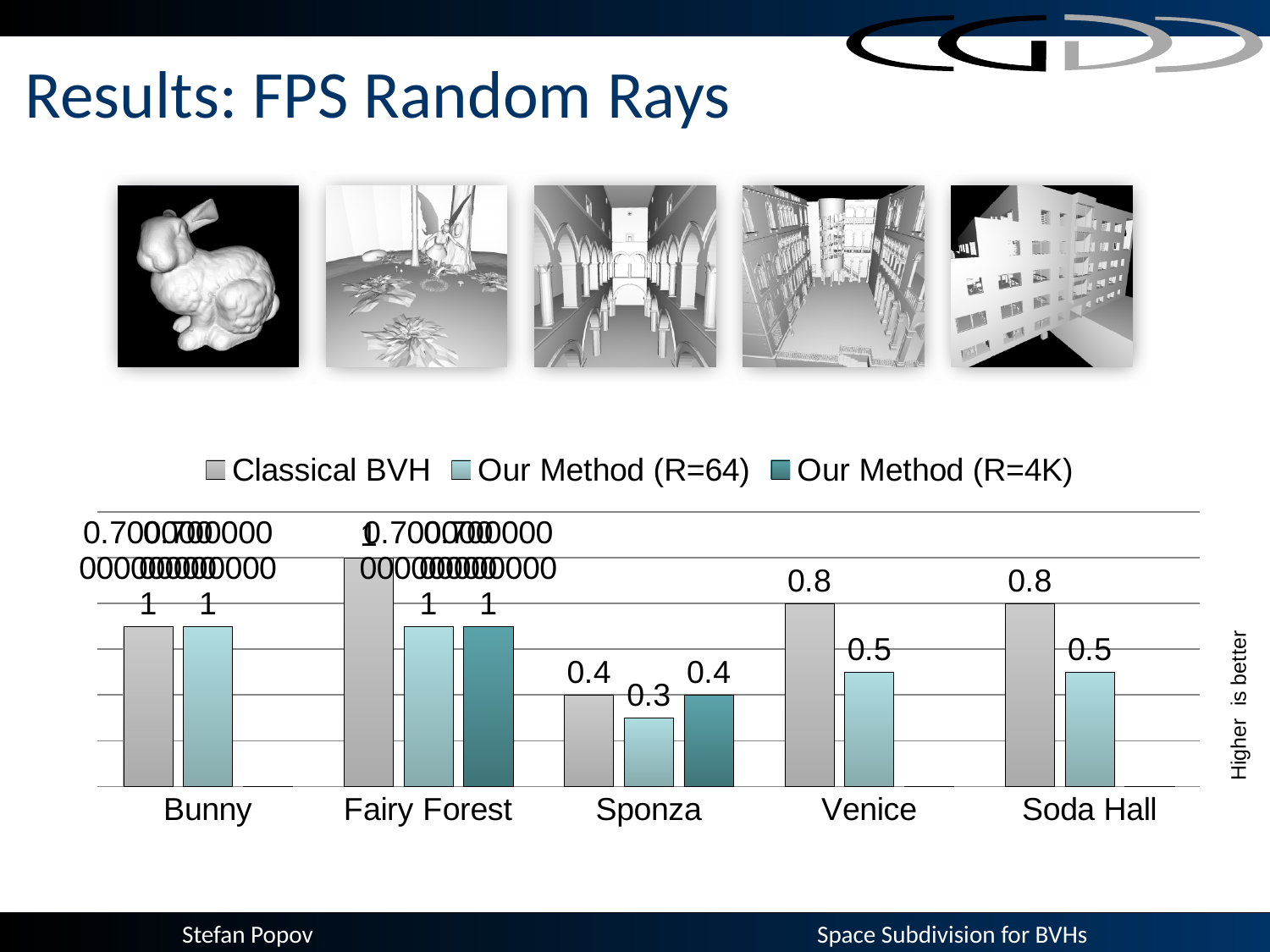
How many scene categories are shown along the x axis of the chart? 5 What is the Our Method (R=64) value for Soda Hall? 0.5 What is the Classical BVH value for Venice? 0.8 For Sponza, which is larger: the Classical BVH value or the Our Method (R=64) value? Classical BVH What is the difference between the Classical BVH and Our Method (R=64) values for Venice? 0.3 What is the Our Method (R=64) value for Sponza? 0.3 What kind of chart is shown on the slide? bar chart How many series does the chart legend list? 3 What does the rotated text to the right of the chart say? Higher is better Which scene has the lowest Our Method (R=64) value? Sponza What is the Classical BVH value for Sponza? 0.4